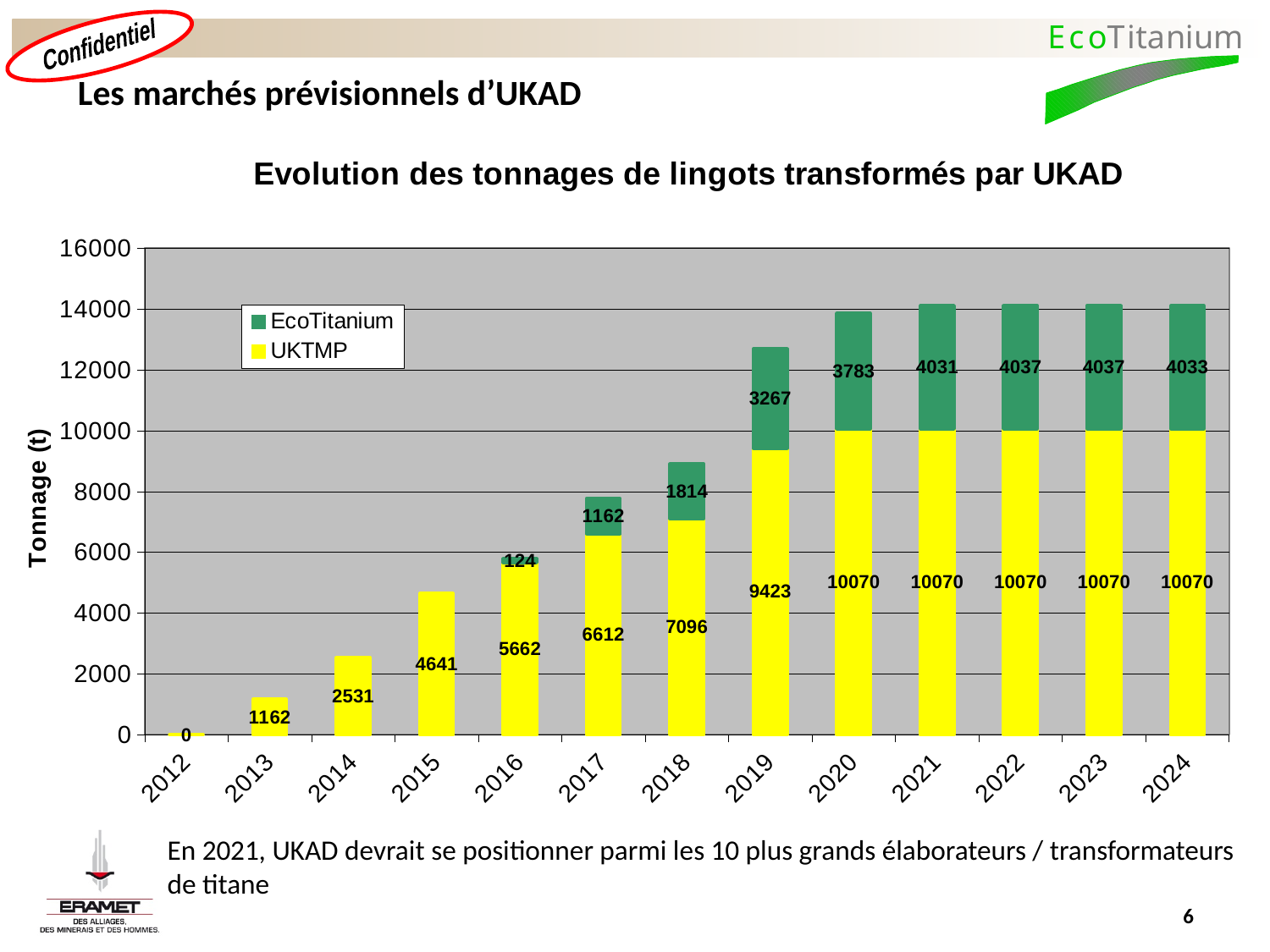
What is the difference between the UKTMP values for 2019 and 2018? 2327 Which is larger, the EcoTitanium value for 2020 or for 2019? 2020 How many years are shown on the x axis? 13 What is the EcoTitanium value for 2019? 3267 How many series does the legend list? 2 What is the UKTMP value for 2022? 10070 What is the EcoTitanium value for 2016? 124 What kind of chart is shown? Stacked bar chart What is the UKTMP value for 2015? 4641 Which year has the lowest UKTMP value? 2012 Which year has the highest EcoTitanium value? 2022 and 2023 What is the total of the stacked bar for 2020? 13853